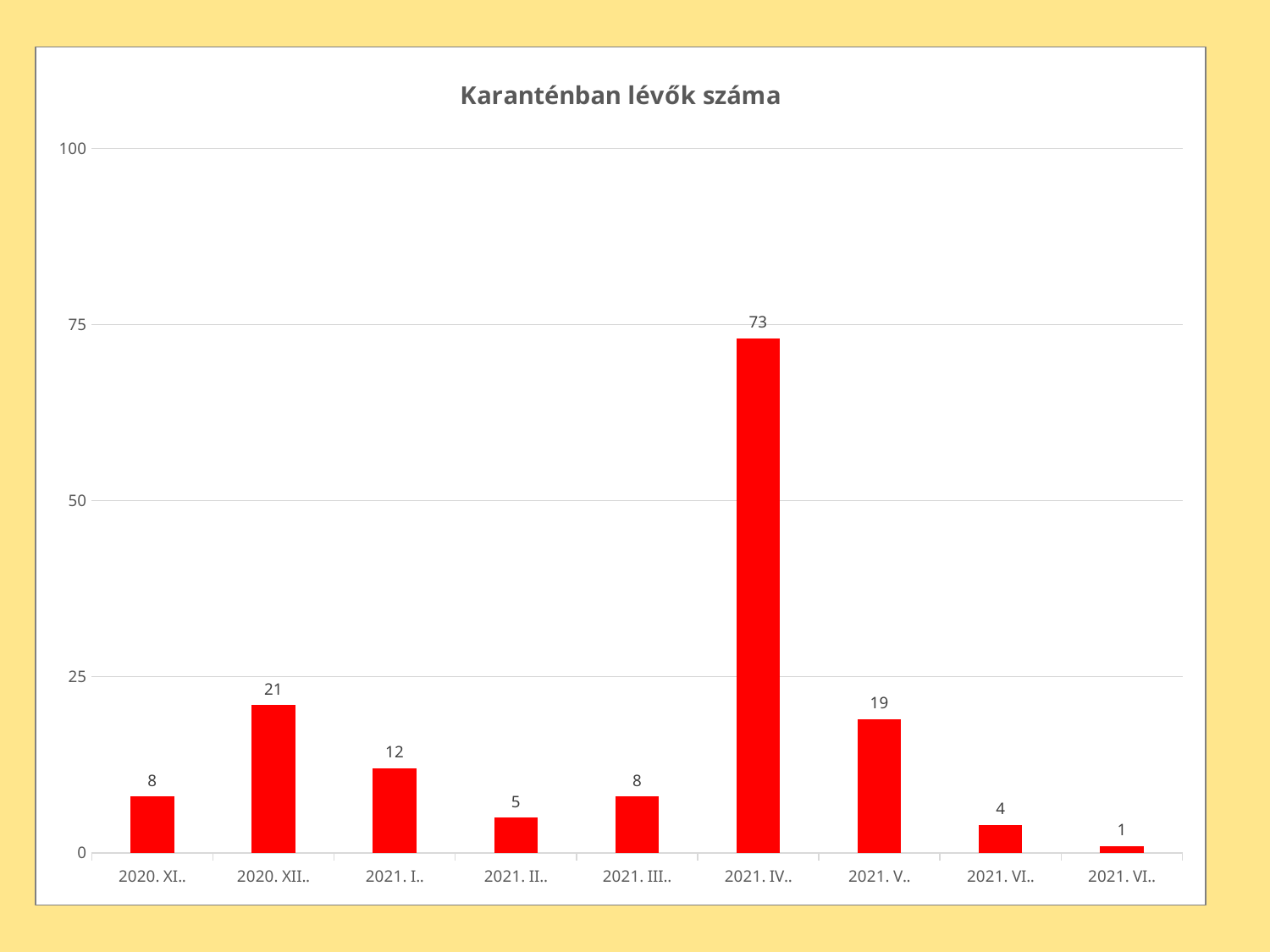
Which category has the highest value? 2021. IV.. How many bars does the chart have? 9 What is the value for 2020. XII..? 21 Which is larger, the value for 2020. XII.. or the value for 2021. I..? 2020. XII.. What is the difference between the values for 2021. IV.. and 2021. V..? 54 What is the title of the chart? Karanténban lévők száma What colour are the bars in the chart? red What is the value of the last bar on the right? 1 What is the value for 2021. IV..? 73 What kind of chart is shown on the slide? bar chart What is the value for 2021. II..? 5 Is the value for 2021. IV.. greater or less than 50? greater